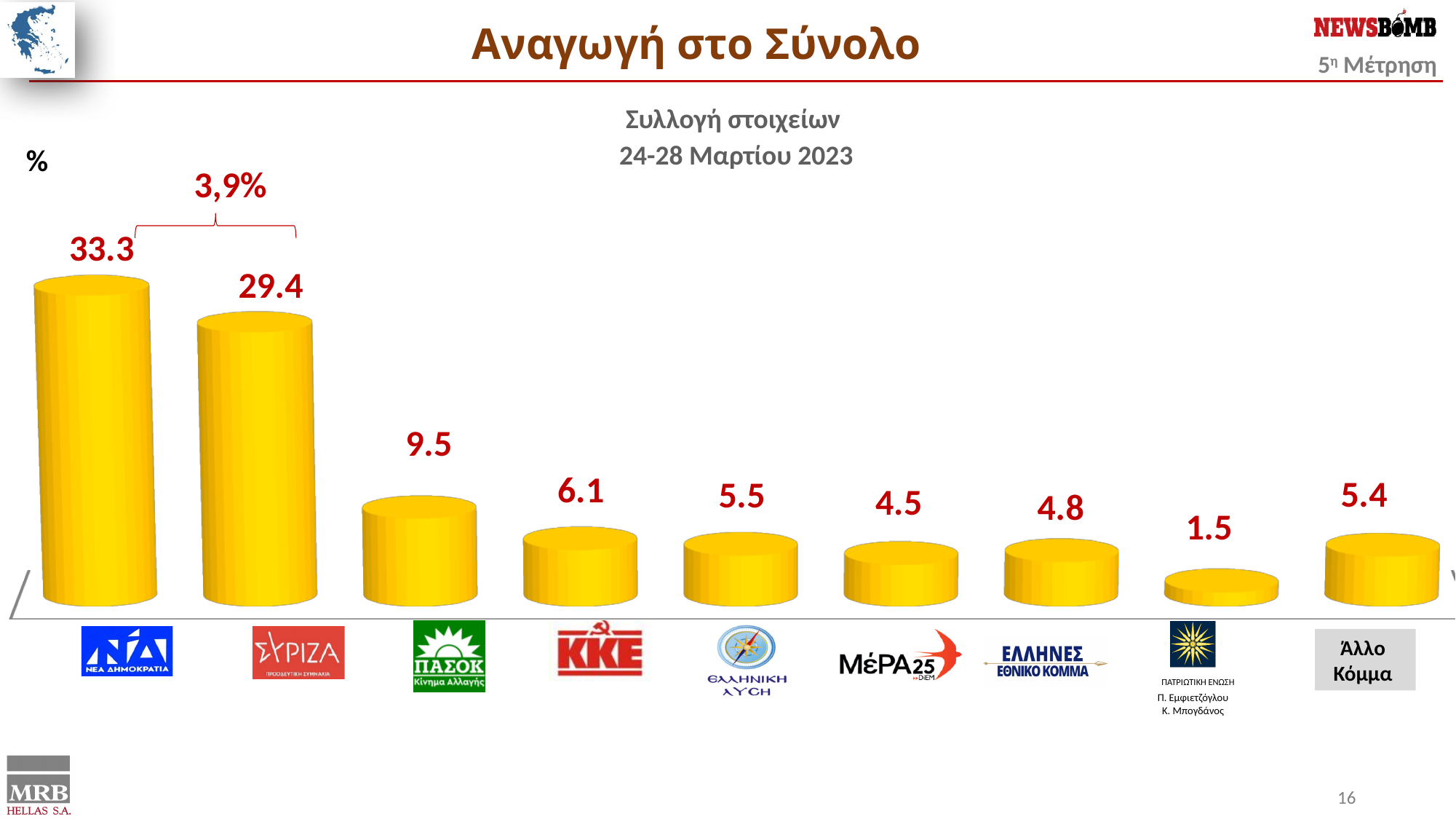
What value is shown for ΚΚΕ? 6.1 What value is shown for ΠΑΤΡΙΩΤΙΚΗ ΕΝΩΣΗ? 1.5 What value is shown for ΠΑΣΟΚ? 9.5 What value is shown for Άλλο Κόμμα? 5.4 What kind of chart is shown on the slide? Bar chart What value is shown for ΣΥΡΙΖΑ? 29.4 What value is shown for ΝΕΑ ΔΗΜΟΚΡΑΤΙΑ? 33.3 Which party has the lowest value? ΠΑΤΡΙΩΤΙΚΗ ΕΝΩΣΗ What is the difference between the values for ΝΕΑ ΔΗΜΟΚΡΑΤΙΑ and ΣΥΡΙΖΑ? 3.9 Which party has the highest value? ΝΕΑ ΔΗΜΟΚΡΑΤΙΑ How many bars are shown in the chart? 9 Which has the larger value, ΜέΡΑ25 or ΕΛΛΗΝΕΣ ΕΘΝΙΚΟ ΚΟΜΜΑ? ΕΛΛΗΝΕΣ ΕΘΝΙΚΟ ΚΟΜΜΑ